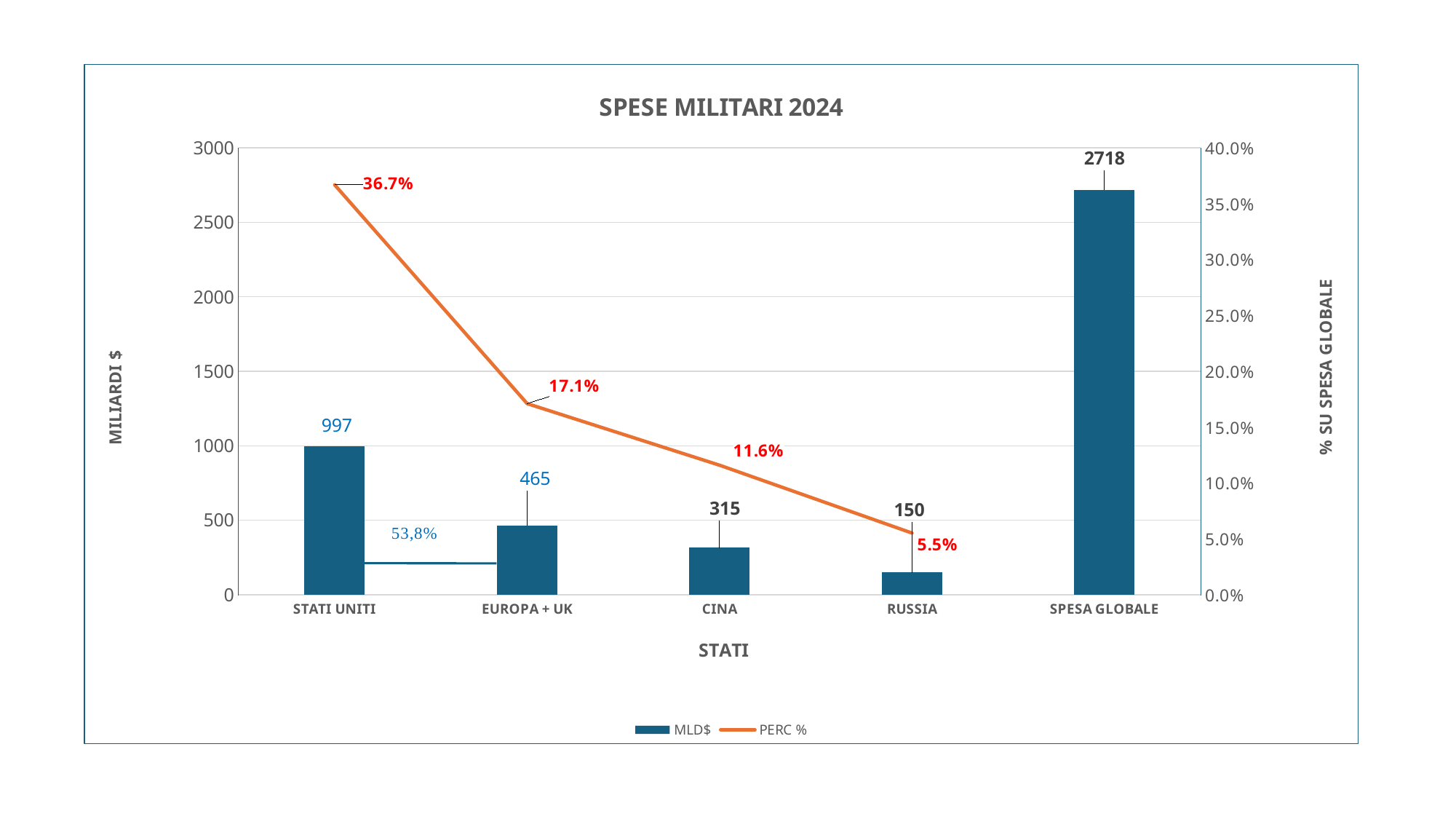
Which category has the lowest MLD$ value? RUSSIA Which category has the highest MLD$ value? SPESA GLOBALE What is the difference in MLD$ between STATI UNITI and EUROPA + UK? 532 Which has a larger MLD$ value, CINA or RUSSIA? CINA What is the PERC % value for RUSSIA? 5.5% What is the MLD$ value for CINA? 315 What is the MLD$ value for STATI UNITI? 997 What is the PERC % value for EUROPA + UK? 17.1% Does the PERC % line rise or fall from STATI UNITI to RUSSIA? fall What is the title of the chart? SPESE MILITARI 2024 How many categories are shown on the x axis? 5 How many series does the legend list? 2